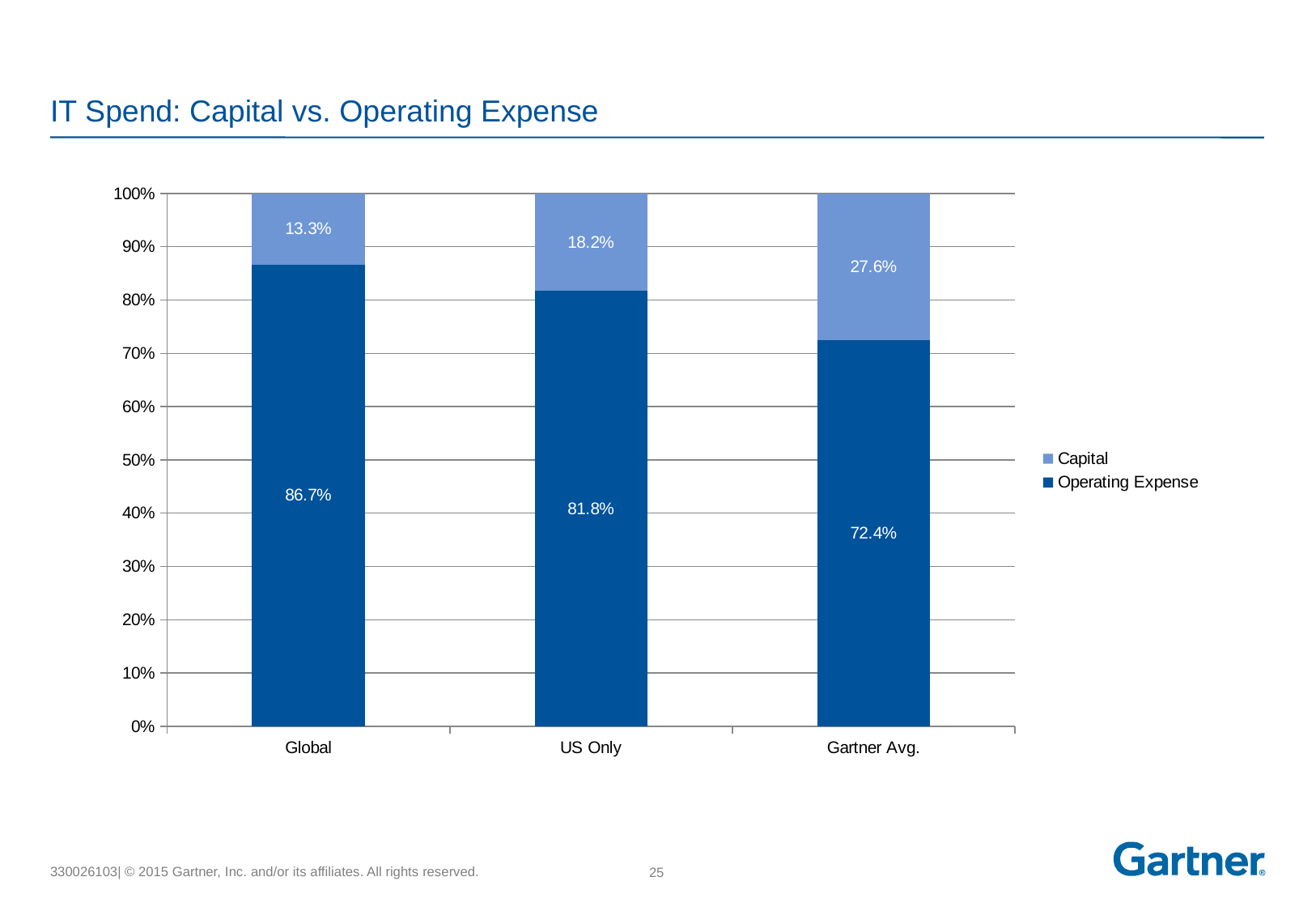
What is the difference between the Capital share for Gartner Avg. and the Capital share for Global? 14.3% What is the title of the chart on the slide? IT Spend: Capital vs. Operating Expense What is the Operating Expense share for US Only? 81.8% How many series does the legend list? 2 What is the Capital share for Global? 13.3% Which category has the lowest Operating Expense share? Gartner Avg. What kind of chart is shown on the slide? Stacked bar chart Which category has the highest Capital share? Gartner Avg. What is the Capital share for Gartner Avg.? 27.6% What is the Operating Expense share for Global? 86.7% Which is larger: the Operating Expense share for US Only or for Gartner Avg.? US Only How many categories are shown on the x axis? 3